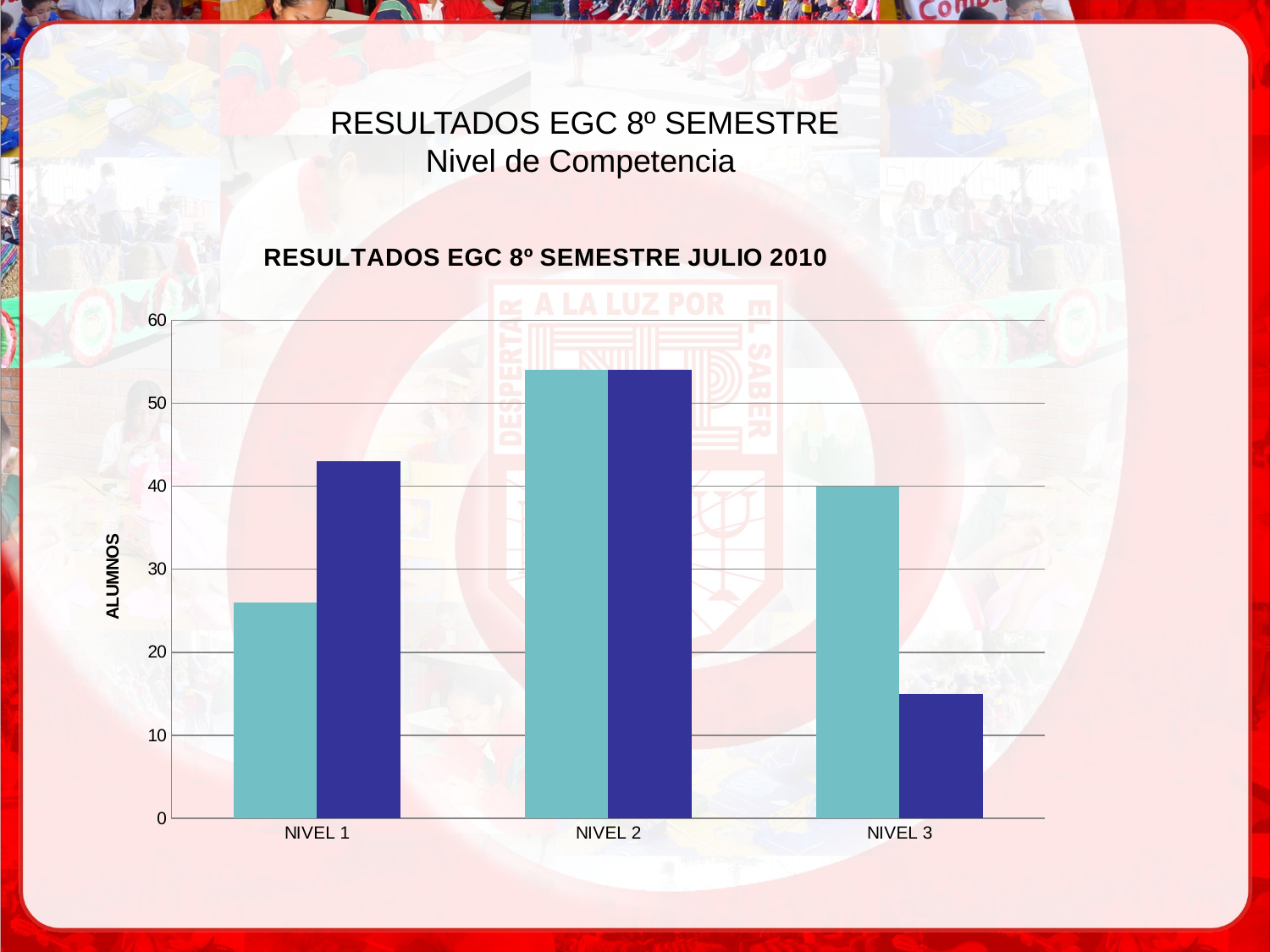
In NIVEL 3, which bar is taller, the light teal bar or the dark blue bar? the light teal bar In NIVEL 1, which bar is taller, the light teal bar or the dark blue bar? the dark blue bar What kind of chart is shown on the slide? bar chart What is the label on the vertical axis of the chart? ALUMNOS Is the value of the light teal bar for NIVEL 2 greater or less than 50? greater For the dark blue bars, which category has the lowest value? NIVEL 3 Is the value of the light teal bar for NIVEL 1 greater or less than 30? less Which category has the tallest bars in the chart? NIVEL 2 How many categories (niveles) are shown on the x axis of the chart? 3 What is the title of the chart? RESULTADOS EGC 8º SEMESTRE JULIO 2010 For the light teal bars, which category has the lowest value? NIVEL 1 Is the value of the dark blue bar for NIVEL 3 greater or less than 20? less